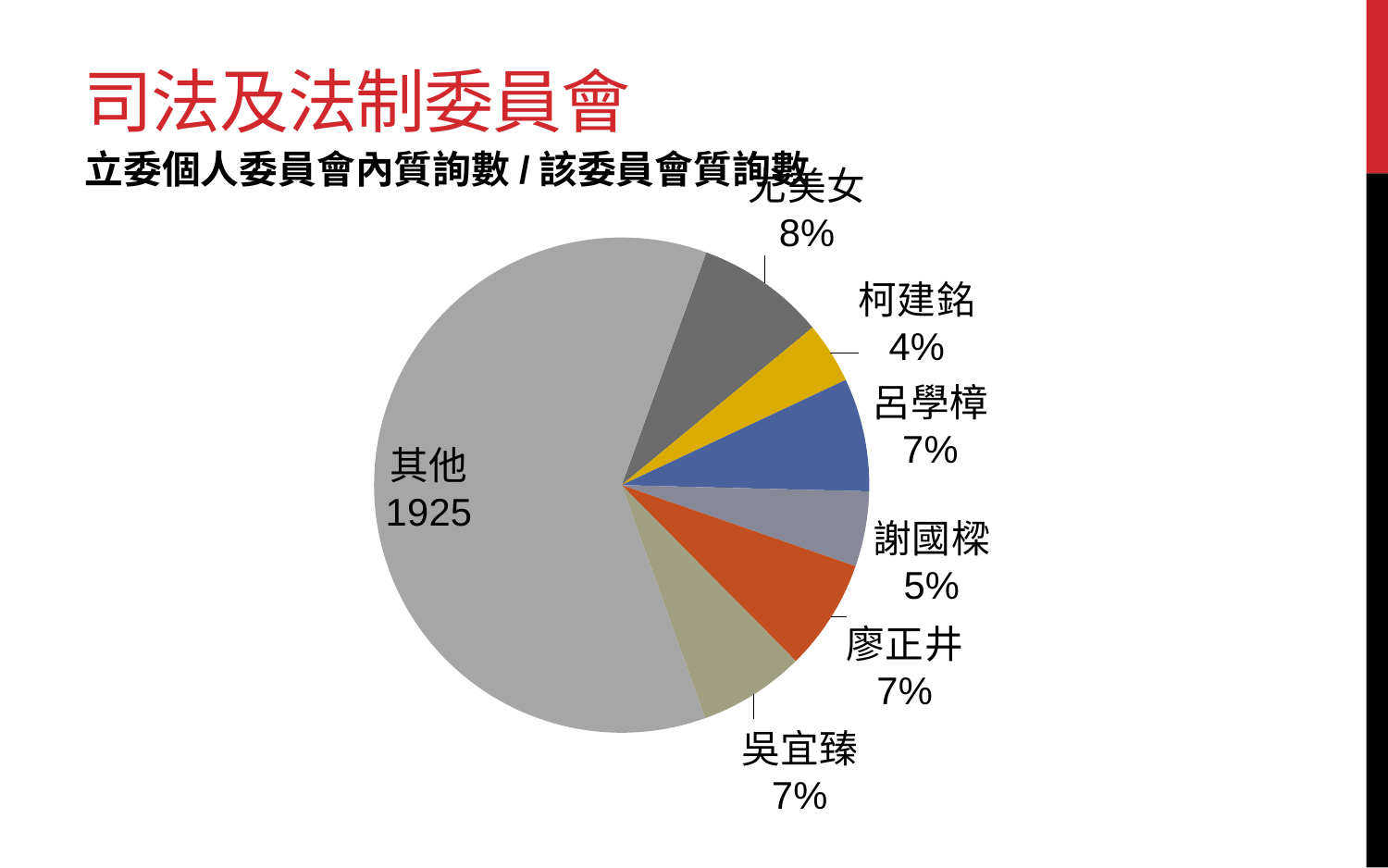
What percentage is shown for 呂學樟? 7% What value is printed on the 其他 slice? 1925 What is the difference in percentage points between 呂學樟 and 柯建銘? 3 Which slice is the largest in the pie chart? 其他 What percentage is shown for 柯建銘 in the pie chart? 4% What percentage is shown for 廖正井? 7% What kind of chart is shown on the slide? pie chart How many slices does the pie chart have? 7 What is the title of the slide? 司法及法制委員會 What percentage is shown for 謝國樑? 5% What percentage is shown for 吳宜臻? 7% Which slice is larger, 柯建銘 or 謝國樑? 謝國樑